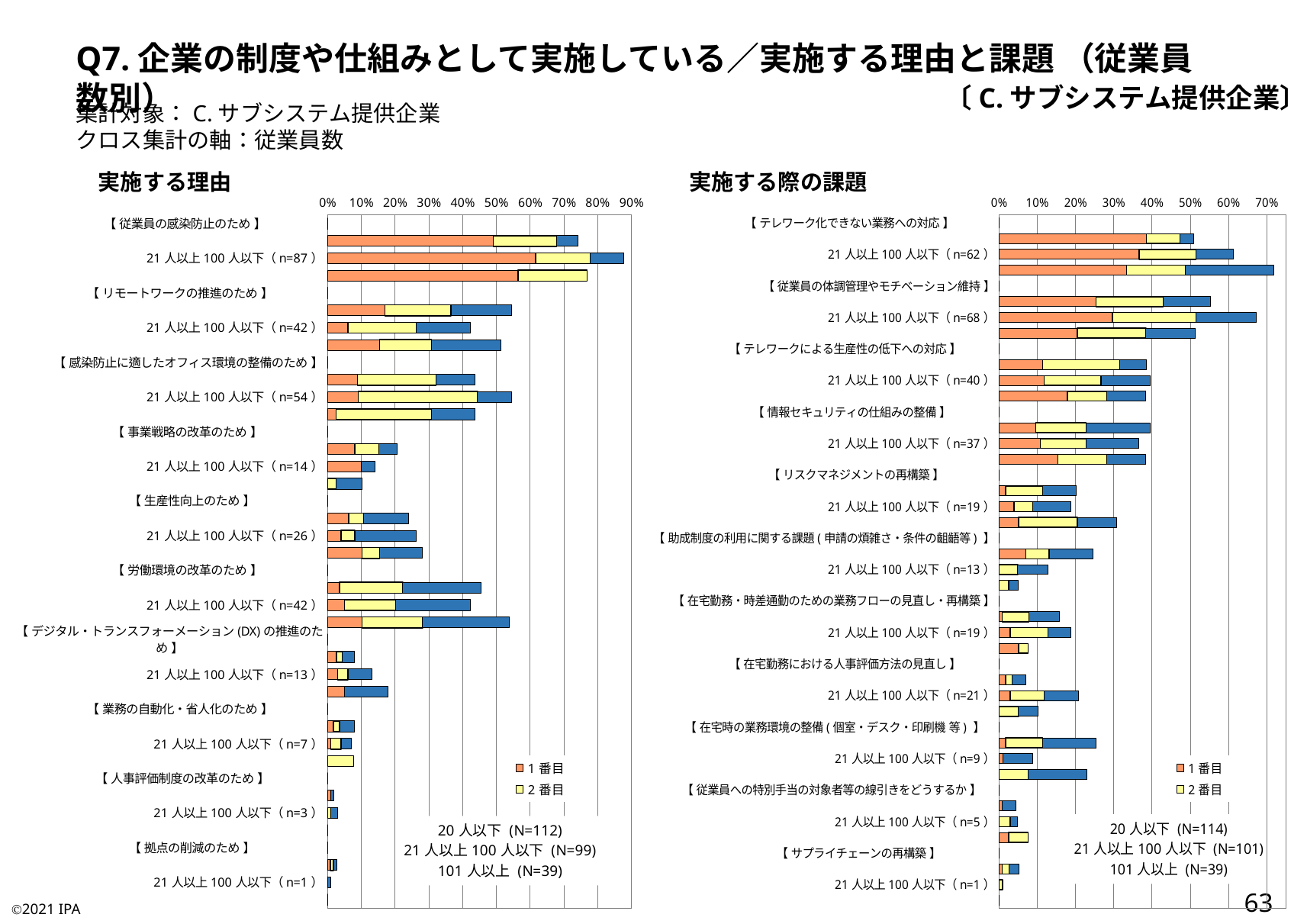
In the right chart (実施する際の課題), which issue category has the longest bar? テレワーク化できない業務への対応 In the left chart (実施する理由), which is larger: the top bar under 従業員の感染防止のため or the top bar under リモートワークの推進のため? 従業員の感染防止のため In the left chart (実施する理由), are the bars under 拠点の削減のため greater or less than 10%? less In the right chart (実施する際の課題), how many issue categories are shown? 11 In the left chart (実施する理由), which reason category has the longest bar? 従業員の感染防止のため What kind of chart is the left chart titled 実施する理由? Stacked horizontal bar chart According to the note in the right chart (実施する際の課題), what is N for 20人以下? 114 In the left chart (実施する理由), how many reason categories are shown? 10 What are the two legend entries shown in the left chart (実施する理由)? 1番目, 2番目 In the left chart (実施する理由), is the total bar for 21人以上100人以下 (n=87) under 従業員の感染防止のため greater or less than 80%? greater How many entries does the legend of the right chart (実施する際の課題) list? 2 In the right chart (実施する際の課題), is the total bar for 21人以上100人以下 (n=68) under 従業員の体調管理やモチベーション維持 greater or less than 60%? greater